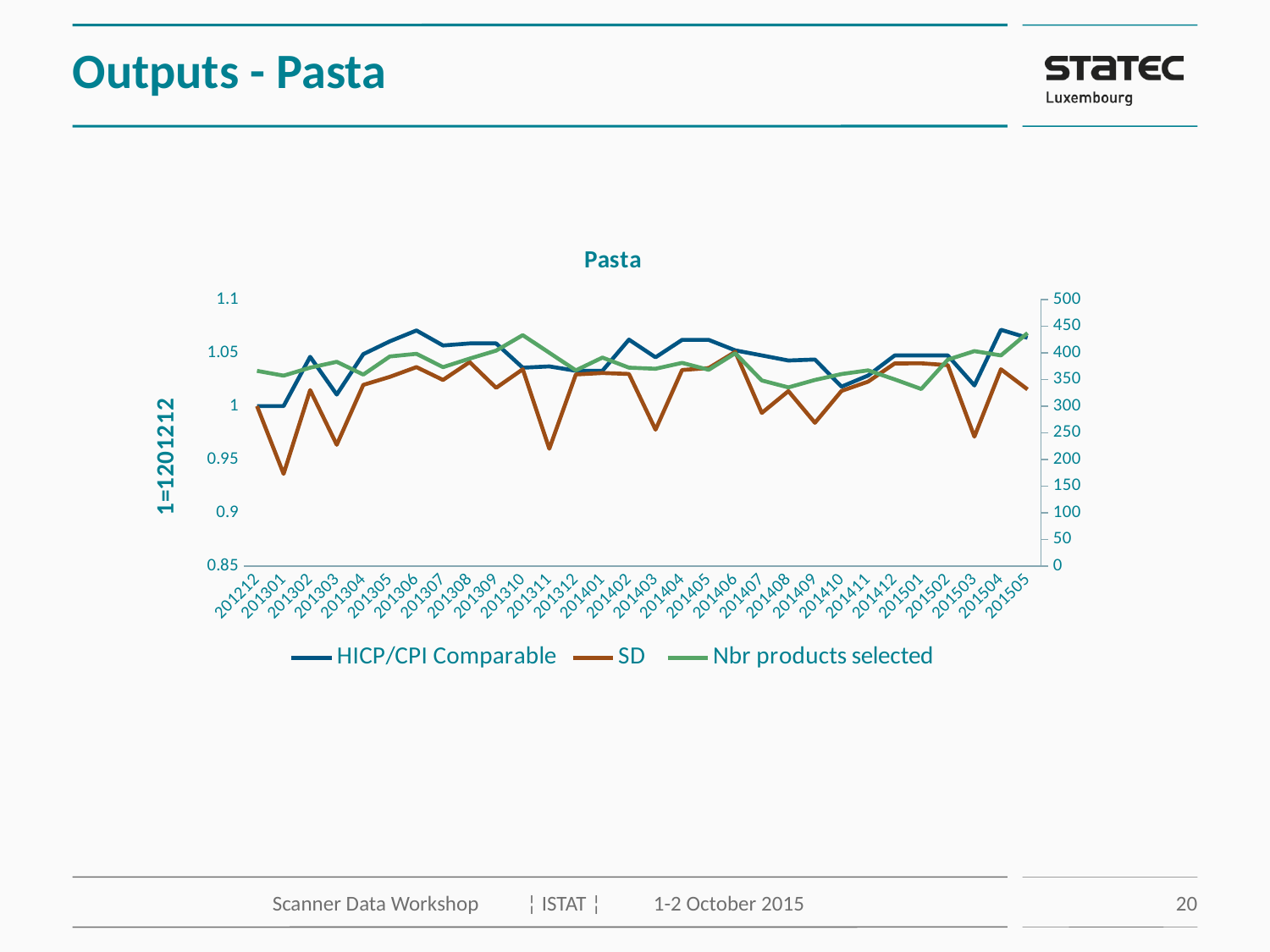
At which period does the SD series reach its lowest value? 201301 How many series does the legend of the Pasta chart list? 3 Is the value of Nbr products selected at 201310 greater or less than 400? greater Is the value of HICP/CPI Comparable at 201306 greater or less than 1.05? greater What kind of chart is shown on the slide? line chart Which is larger for the SD series: the value at 201301 or the value at 201302? 201302 What is the highest value shown on the right-hand axis of the chart? 500 Does the HICP/CPI Comparable series overall rise or fall from 201212 to 201505? rise What is the title of the chart? Pasta How many time points are plotted along the x axis of the Pasta chart? 30 Is the value of SD at 201301 greater or less than 0.95? less